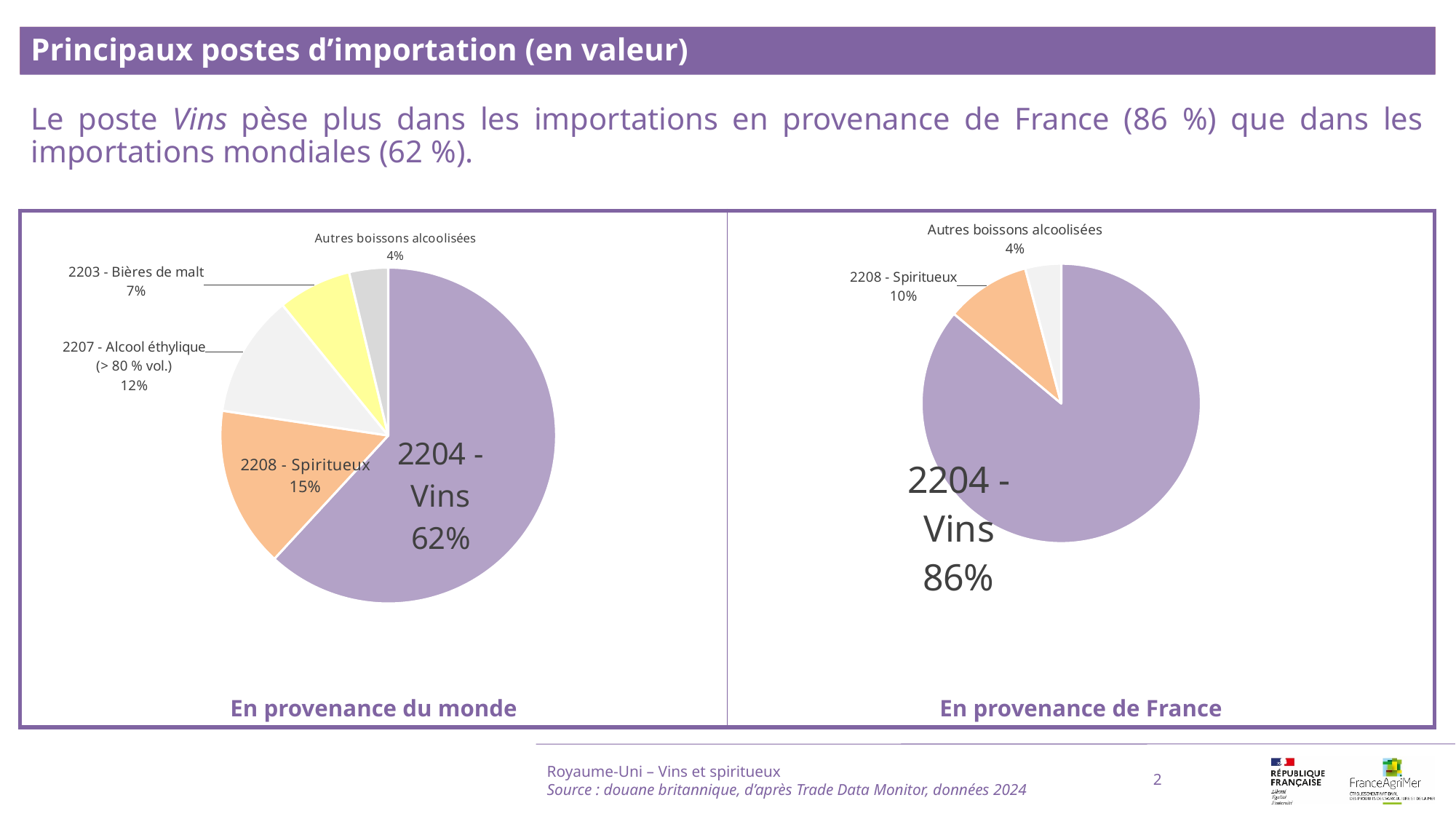
In the 'En provenance de France' chart, what share does 2204 - Vins have? 86% How many slices does the 'En provenance du monde' chart have? 5 In the 'En provenance du monde' chart, what share does 2208 - Spiritueux have? 15% In the 'En provenance du monde' chart, what share does 2204 - Vins have? 62% In the 'En provenance du monde' chart, which category has the smallest share? Autres boissons alcoolisées In the 'En provenance du monde' chart, which is larger: 2203 - Bières de malt or 2207 - Alcool éthylique (> 80 % vol.)? 2207 - Alcool éthylique (> 80 % vol.) In the 'En provenance de France' chart, which category has the largest share? 2204 - Vins How many slices does the 'En provenance de France' chart have? 3 What type of chart is used on this slide? Pie chart What is the difference between the share of 2204 - Vins in the 'En provenance de France' chart and in the 'En provenance du monde' chart? 24 percentage points In the 'En provenance de France' chart, what share does 2208 - Spiritueux have? 10% In the 'En provenance du monde' chart, what share does 2207 - Alcool éthylique (> 80 % vol.) have? 12%